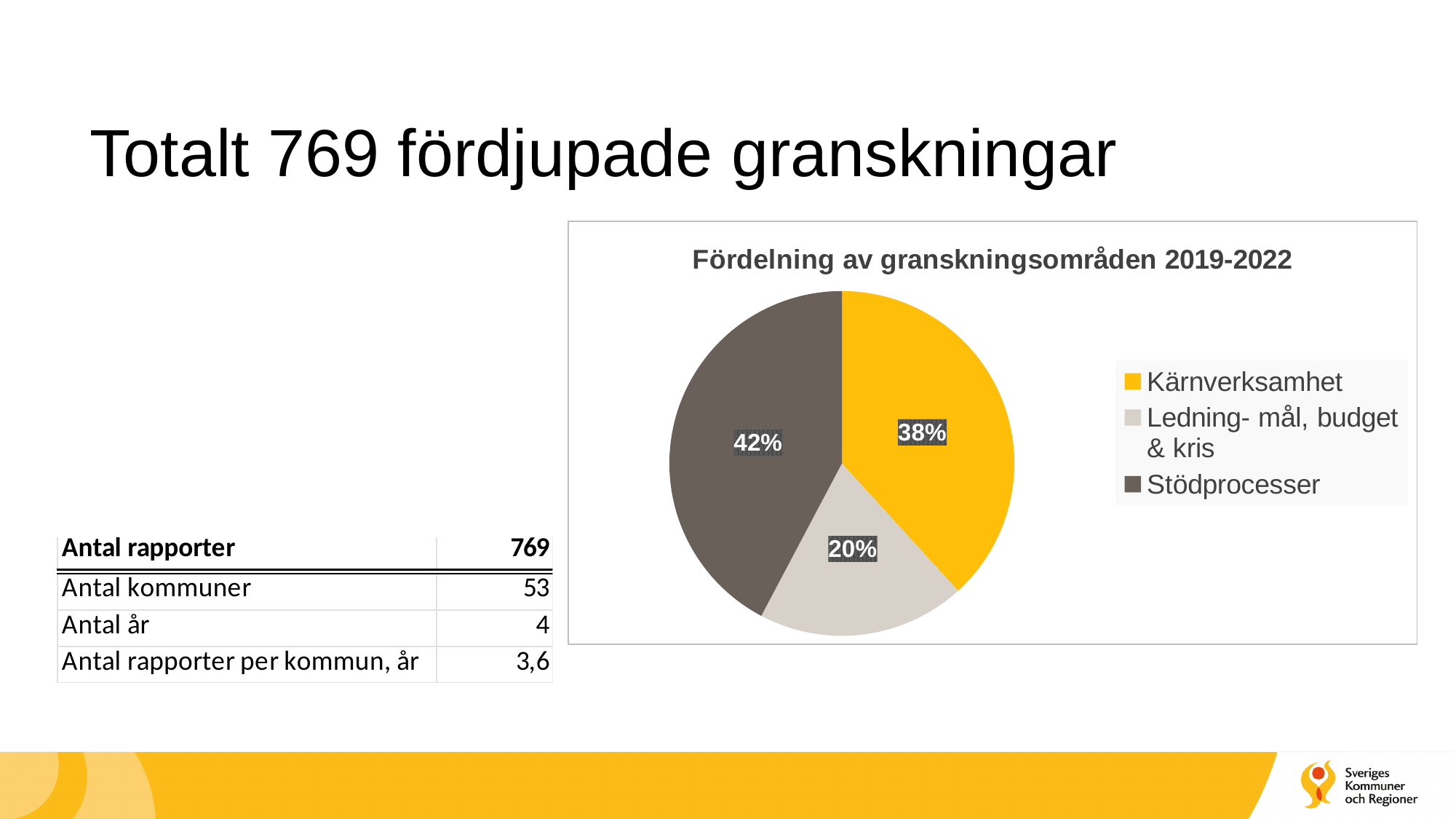
Which category is shown in yellow in the pie chart? Kärnverksamhet What share of the pie does Kärnverksamhet have? 38% Which is larger, the share for Kärnverksamhet or the share for Ledning- mål, budget & kris? Kärnverksamhet What share of the pie does Ledning- mål, budget & kris have? 20% What is the difference in percentage points between Kärnverksamhet and Ledning- mål, budget & kris? 18 What is the title of the chart? Fördelning av granskningsområden 2019-2022 Which category has the largest share of the pie? Stödprocesser How many slices does the pie chart have? 3 What kind of chart is shown on the slide? Pie chart Which category has the smallest share of the pie? Ledning- mål, budget & kris What is the difference in percentage points between Stödprocesser and Kärnverksamhet? 4 What share of the pie does Stödprocesser have? 42%